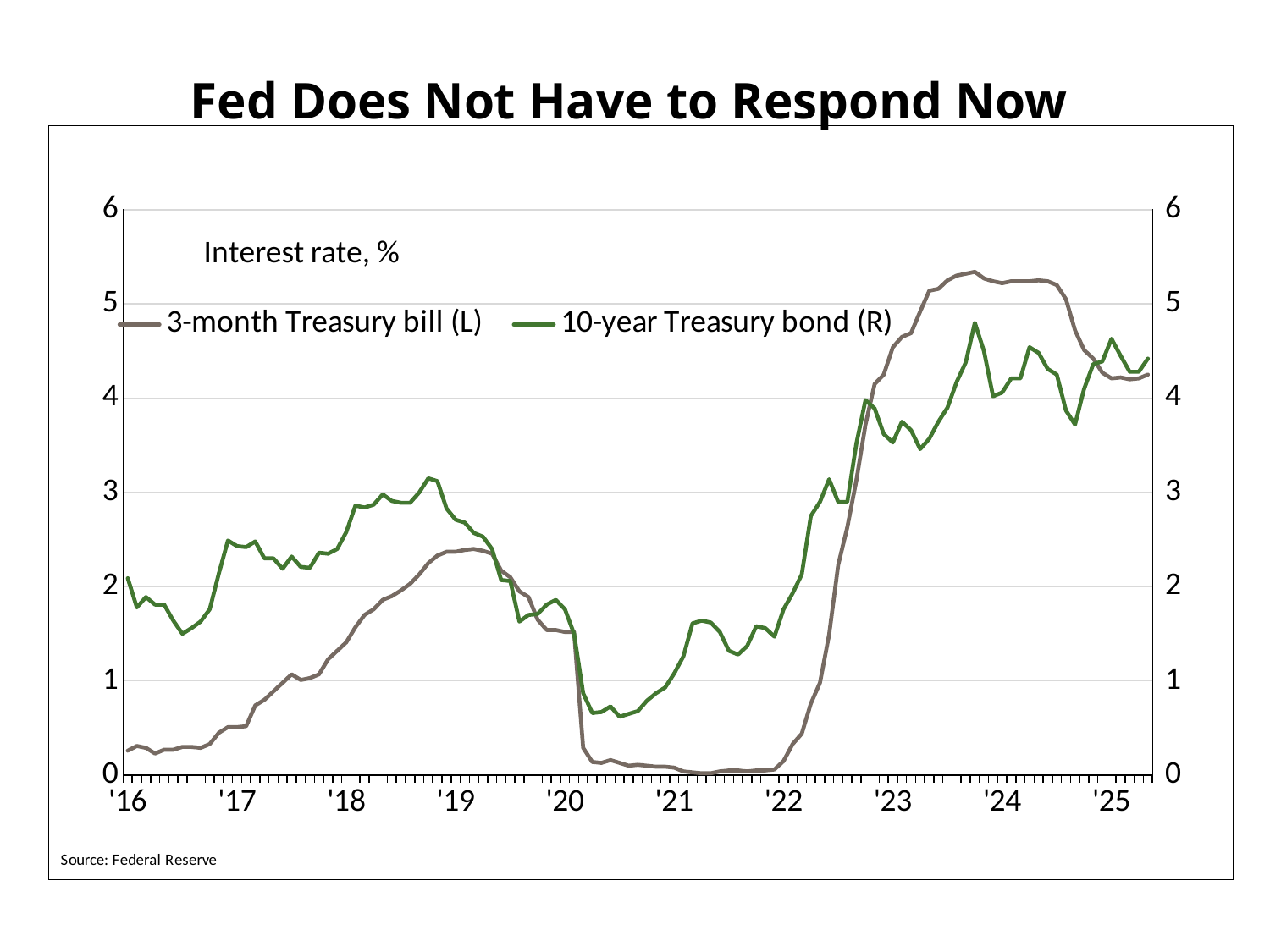
At the start of '24, which series has the higher value, the 3-month Treasury bill or the 10-year Treasury bond? 3-month Treasury bill Which series reaches the higher peak over the whole period shown? 3-month Treasury bill What kind of chart is shown on the slide? line chart What are the two series named in the legend? 3-month Treasury bill (L) and 10-year Treasury bond (R) Does the 3-month Treasury bill rise or fall between the start of '22 and the start of '23? rise At the start of '18, which series has the higher value, the 3-month Treasury bill or the 10-year Treasury bond? 10-year Treasury bond Is the value of the 10-year Treasury bond at the start of '19 greater or less than 2? greater How many series does the legend list? 2 Is the value of the 3-month Treasury bill at the start of '21 greater or less than 1? less Is the value of the 10-year Treasury bond in mid-'20 greater or less than 1? less What is the title of the slide? Fed Does Not Have to Respond Now